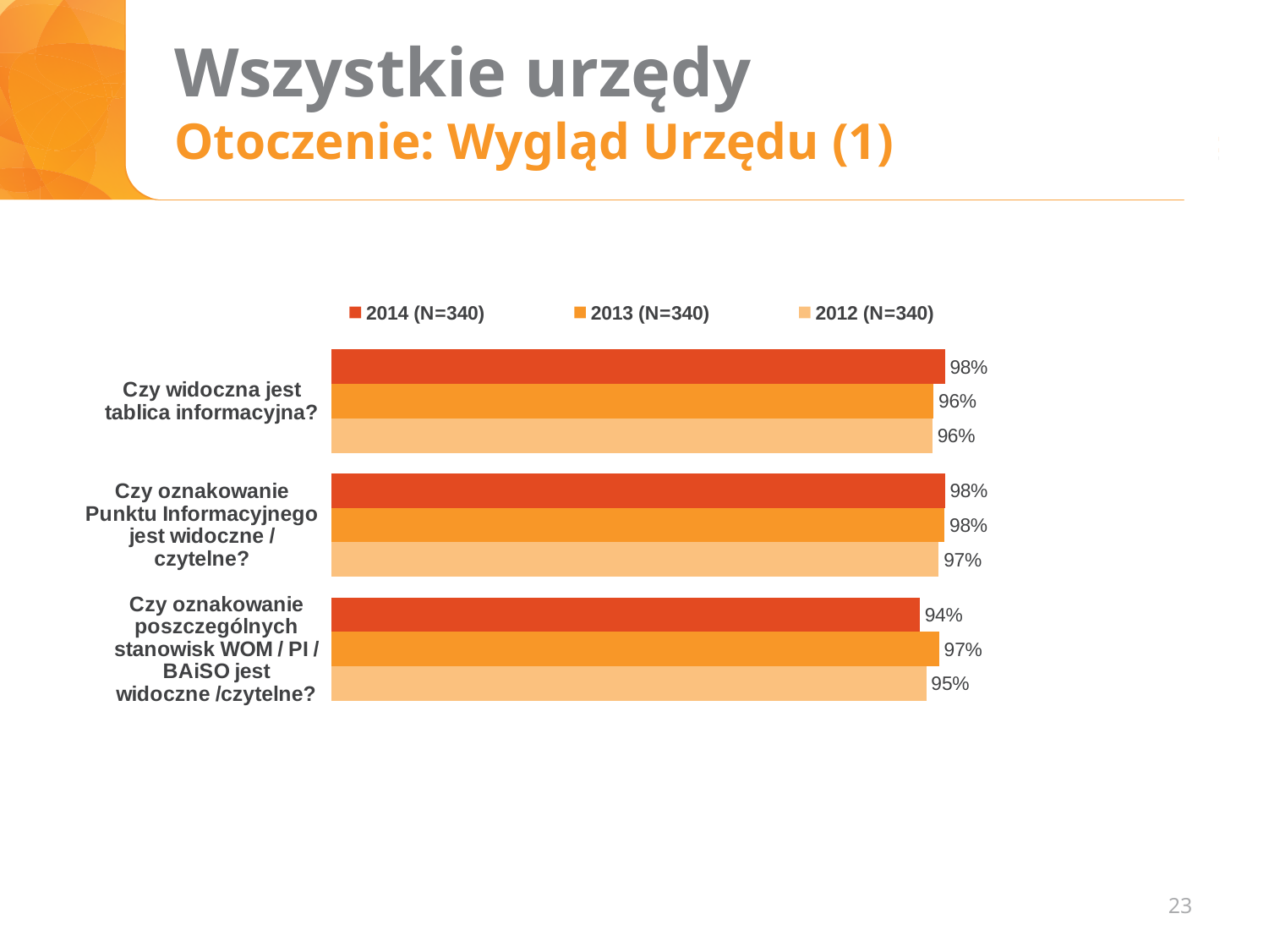
How many categories are shown on the chart? 3 What is the difference between the 2013 (N=340) and 2014 (N=340) values for "Czy oznakowanie poszczególnych stanowisk WOM / PI / BAiSO jest widoczne /czytelne?"? 3% What is the 2014 (N=340) value for "Czy widoczna jest tablica informacyjna?"? 98% What is the 2012 (N=340) value for "Czy oznakowanie Punktu Informacyjnego jest widoczne / czytelne?"? 97% What is the 2014 (N=340) value for "Czy oznakowanie poszczególnych stanowisk WOM / PI / BAiSO jest widoczne /czytelne?"? 94% Which category has the lowest 2014 (N=340) value? Czy oznakowanie poszczególnych stanowisk WOM / PI / BAiSO jest widoczne /czytelne? What is the 2013 (N=340) value for "Czy oznakowanie poszczególnych stanowisk WOM / PI / BAiSO jest widoczne /czytelne?"? 97% Which series is shown in the lightest orange colour? 2012 (N=340) For "Czy oznakowanie poszczególnych stanowisk WOM / PI / BAiSO jest widoczne /czytelne?", which is larger: the 2013 (N=340) value or the 2012 (N=340) value? 2013 (N=340) What is the difference between the 2014 (N=340) and 2013 (N=340) values for "Czy widoczna jest tablica informacyjna?"? 2% What kind of chart is shown on the slide? Bar chart How many series does the legend list? 3